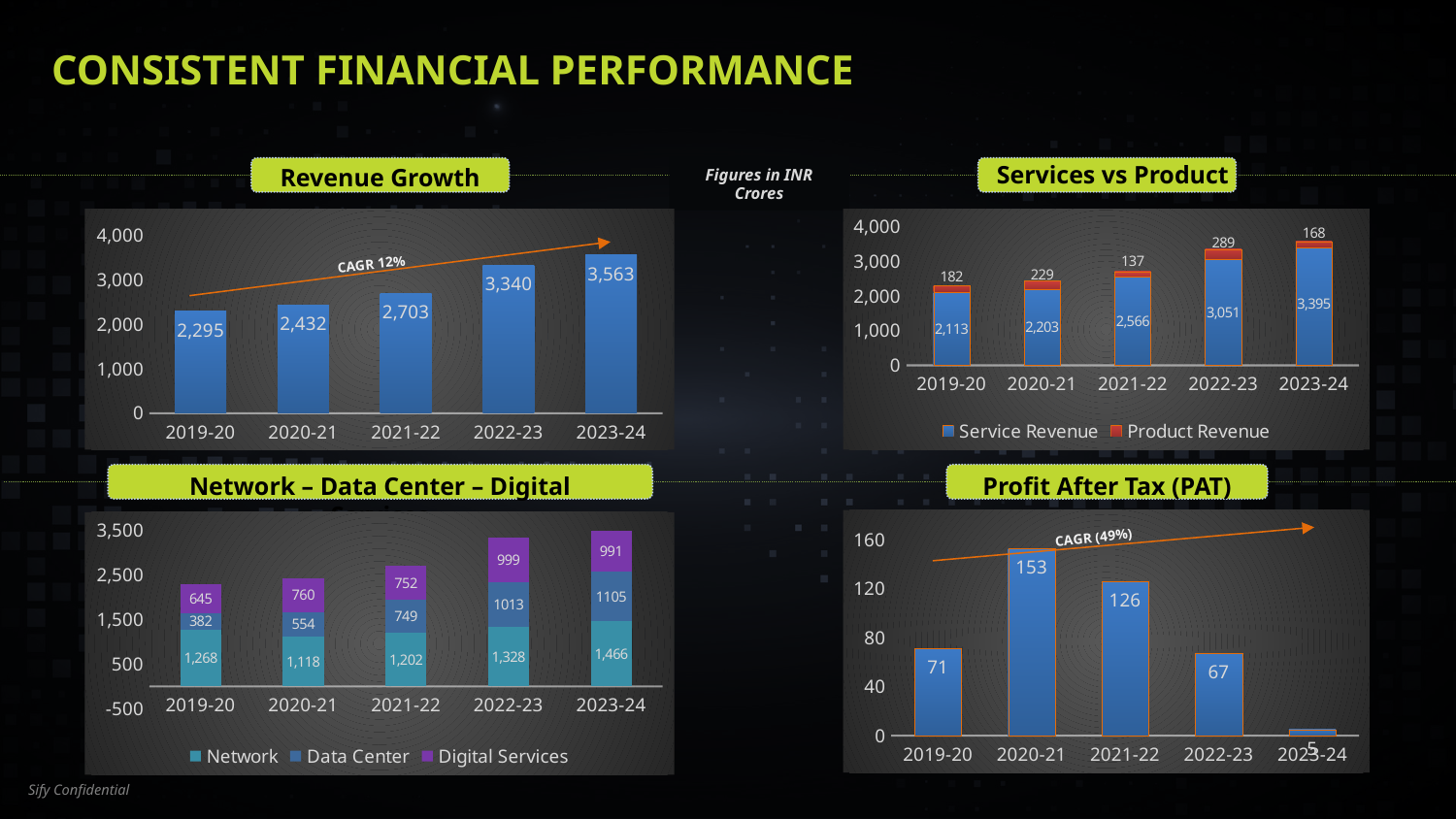
In the Revenue Growth chart, what is the difference between the 2022-23 and 2021-22 values? 637 In the Services vs Product chart, what is the Product Revenue for 2022-23? 289 In the Profit After Tax (PAT) chart, what is the value for 2020-21? 153 In the Services vs Product chart, what is the total of Service Revenue and Product Revenue for 2023-24? 3,563 In the Network – Data Center – Digital chart, which year has the highest Network value? 2023-24 What kind of chart is the Revenue Growth chart? Bar chart In the Network – Data Center – Digital chart, how many series does the legend list? 3 In the Revenue Growth chart, what CAGR is shown? 12% In the Profit After Tax (PAT) chart, is the value for 2021-22 larger than the value for 2022-23? Yes In the Services vs Product chart, which year has the lowest Product Revenue? 2021-22 In the Revenue Growth chart, what is the revenue for 2023-24? 3,563 In the Network – Data Center – Digital chart, what is the Data Center value for 2021-22? 749